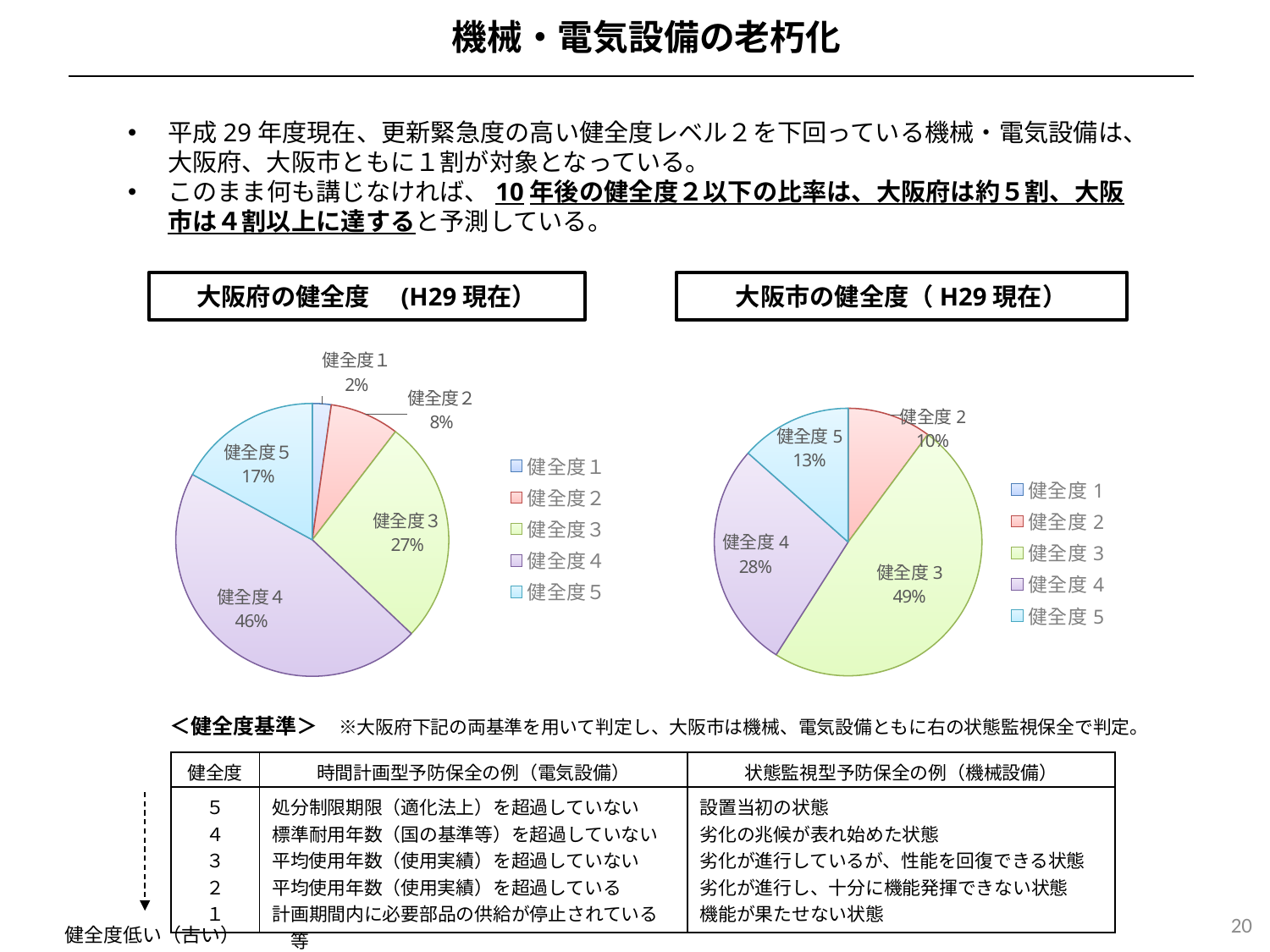
In the 大阪府の健全度 (H29現在) chart, what percentage is 健全度1? 2% In the 大阪市の健全度 (H29現在) chart, what is the difference in percentage points between 健全度4 and 健全度2? 18 In the 大阪府の健全度 (H29現在) chart, what percentage is 健全度4? 46% In the 大阪市の健全度 (H29現在) chart, what percentage is 健全度5? 13% Which is larger: 健全度5 in the 大阪府の健全度 chart or 健全度5 in the 大阪市の健全度 chart? 大阪府の健全度 In the 大阪市の健全度 (H29現在) chart, what percentage is 健全度3? 49% What type of chart is used for 大阪府の健全度 (H29現在)? Pie chart In the 大阪府の健全度 (H29現在) chart, which category has the largest share? 健全度4 In the 大阪府の健全度 (H29現在) chart, what is the difference in percentage points between 健全度4 and 健全度3? 19 In the 大阪市の健全度 (H29現在) chart, which labeled category has the largest share? 健全度3 How many entries does the legend of the 大阪市の健全度 (H29現在) chart list? 5 In the 大阪府の健全度 (H29現在) chart, which category has the smallest share? 健全度1